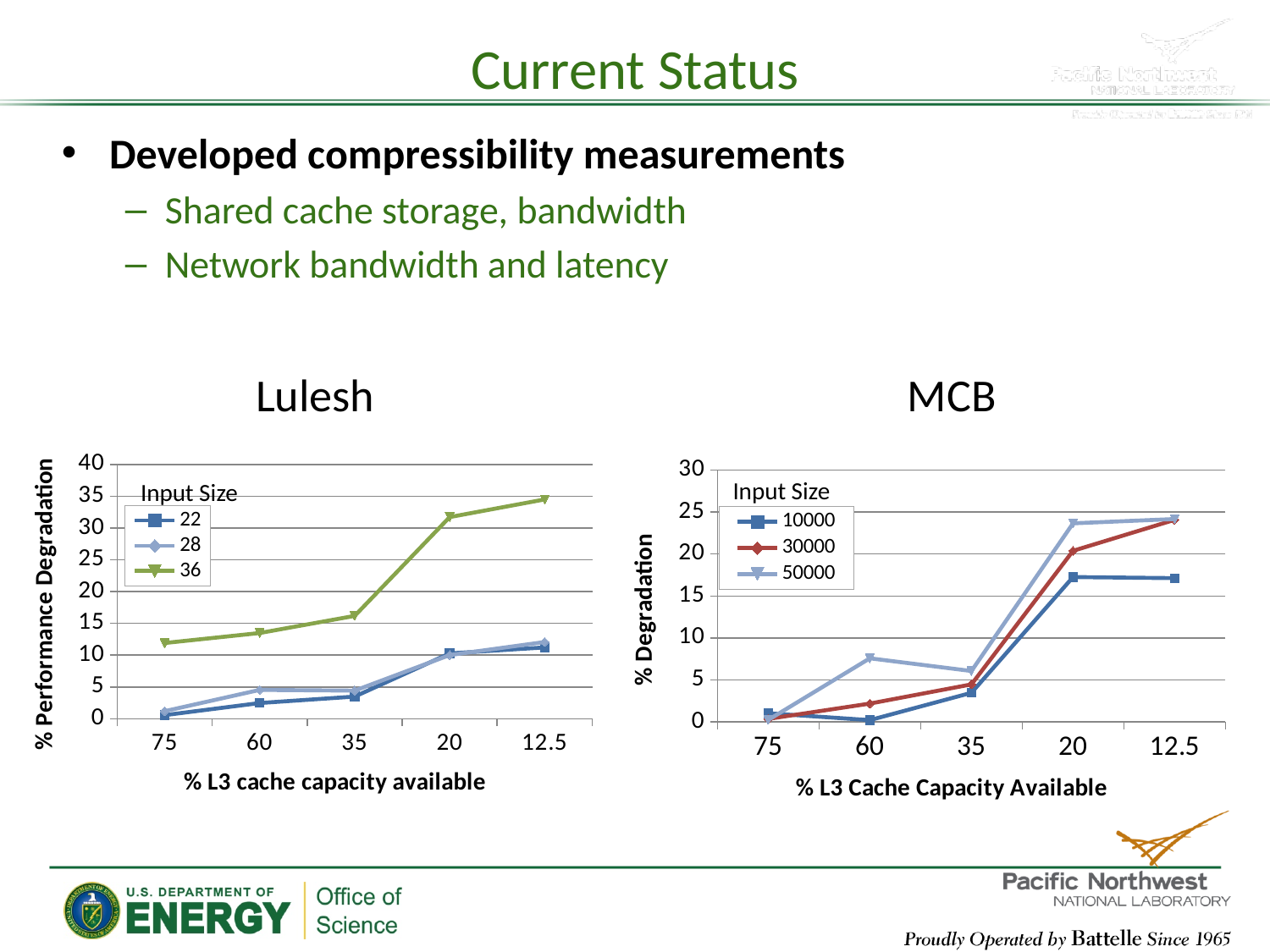
In the Lulesh chart, is the value for input size 22 at 75% cache capacity greater or less than 5? less In the Lulesh chart, which input size series has the highest performance degradation at 12.5% L3 cache capacity? 36 What type of chart is the Lulesh chart? line chart In the Lulesh chart, is the value for input size 36 at 12.5% cache capacity greater or less than 30? greater In the MCB chart, is the value for input size 10000 at 12.5% cache capacity greater or less than 20? less How many x-axis categories are shown on the MCB chart? 5 How many series does the legend of the Lulesh chart list? 3 What is the y-axis title of the MCB chart? % Degradation In the Lulesh chart, do the values for input size 36 rise or fall moving from 75 to 12.5 along the x axis? rise How many series does the legend of the MCB chart list? 3 In the MCB chart, which is larger at 20% cache capacity: the value for input size 50000 or for input size 10000? 50000